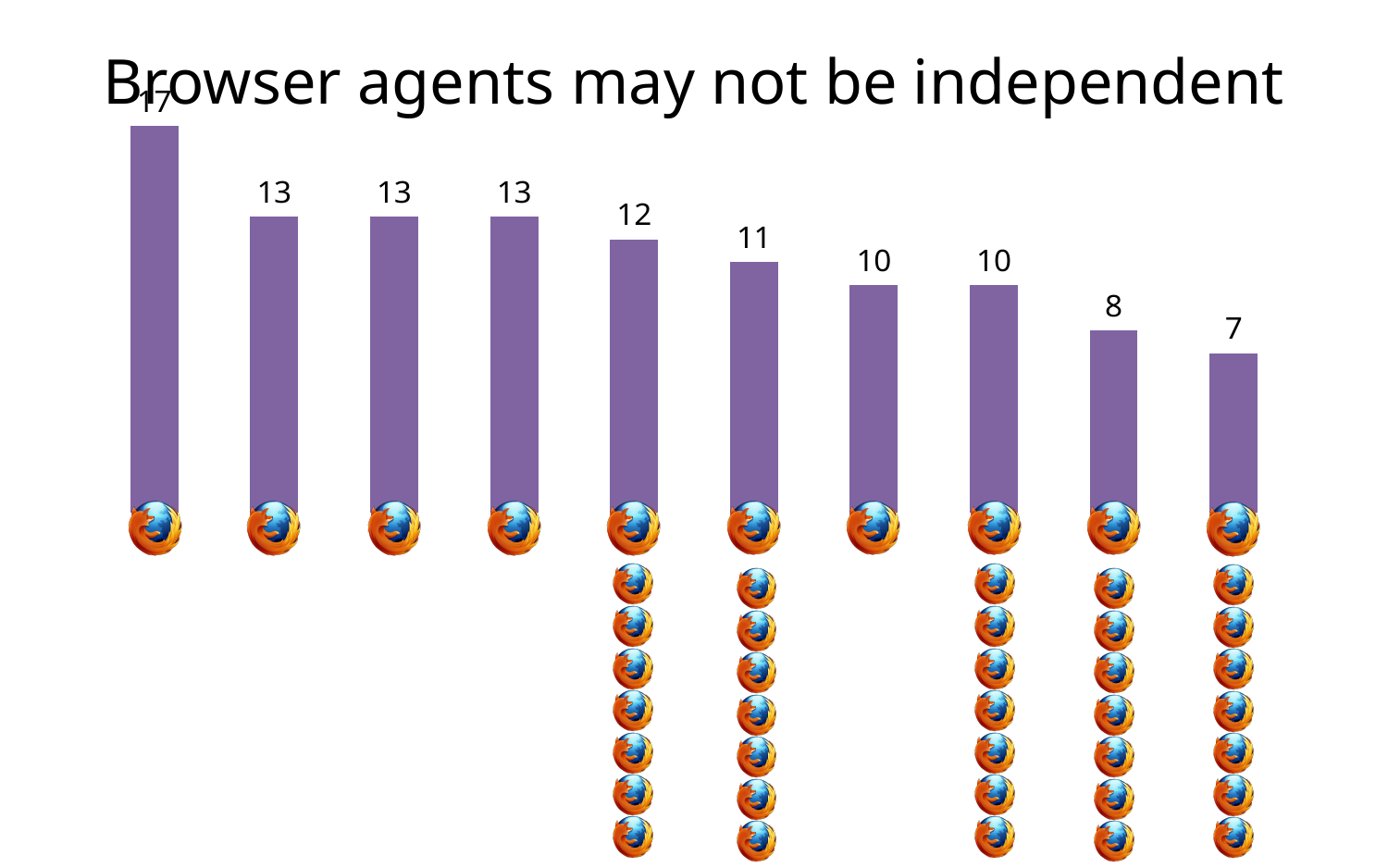
Do the bar values rise or fall from left to right across the chart? fall What is the title of the slide containing the chart? Browser agents may not be independent What is the value of the sixth bar from the left? 11 What kind of chart is shown on the slide? bar chart What is the value of the last (rightmost) bar? 7 What is the value of the first (leftmost) bar? 17 What is the difference between the leftmost bar and the rightmost bar? 10 What is the lowest value shown in the chart? 7 Which is larger, the value of the second bar or the value of the ninth bar? the second bar How many bars does the chart contain? 10 What is the highest value shown in the chart? 17 What is the value of the fifth bar from the left? 12